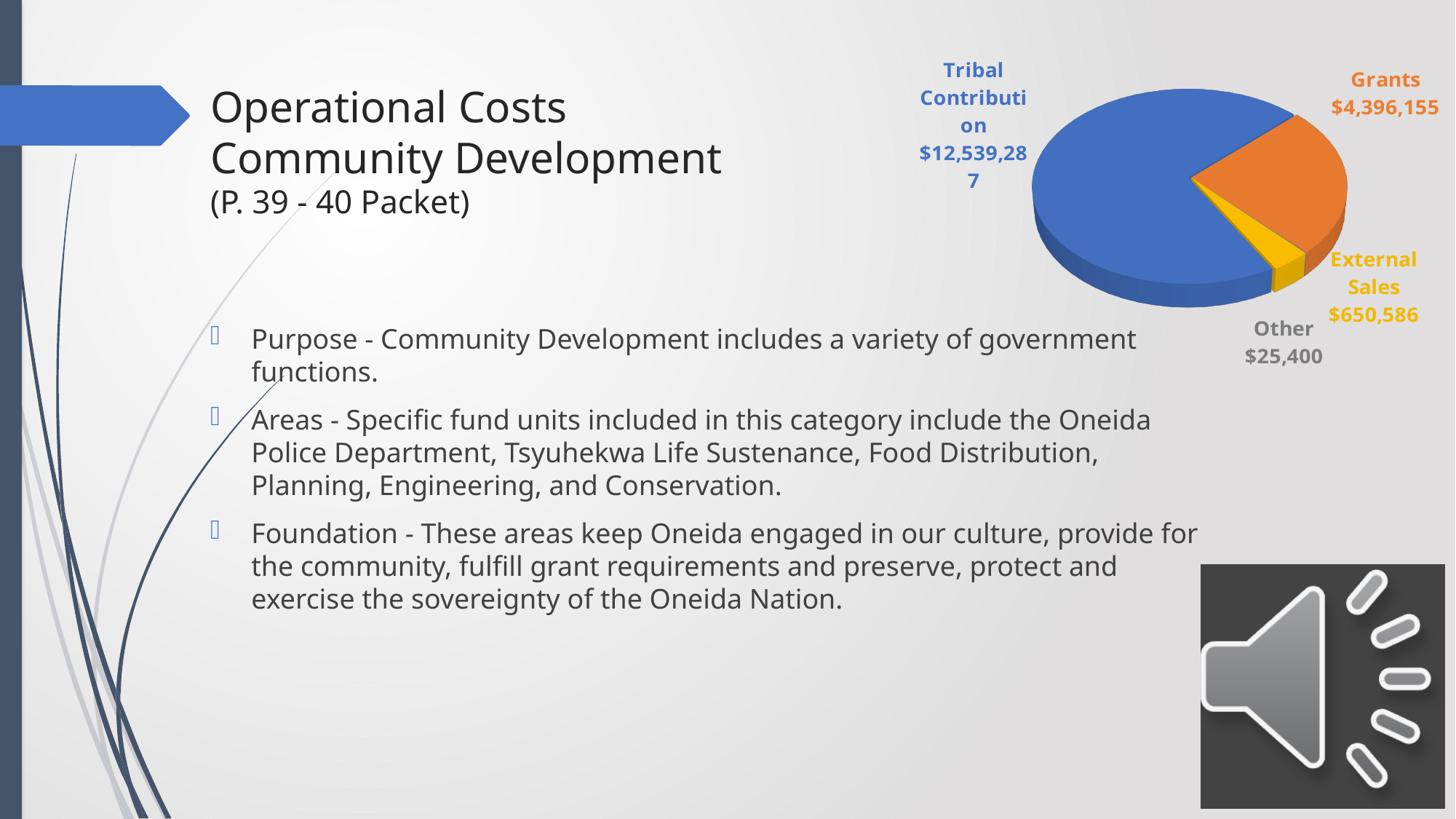
What is the value of the External Sales slice? $650,586 Which category has the largest slice of the pie? Tribal Contribution How many slices does the pie chart have? 4 What type of chart is shown on the slide? Pie chart Which category has the smallest slice of the pie? Other What is the difference between External Sales and Other? $625,186 What is the difference between Tribal Contribution and Grants? $8,143,132 Which is larger, Grants or External Sales? Grants What is the value of the Other slice? $25,400 What colour is the Grants slice? Orange What is the value of the Grants slice? $4,396,155 What is the value of the Tribal Contribution slice? $12,539,287